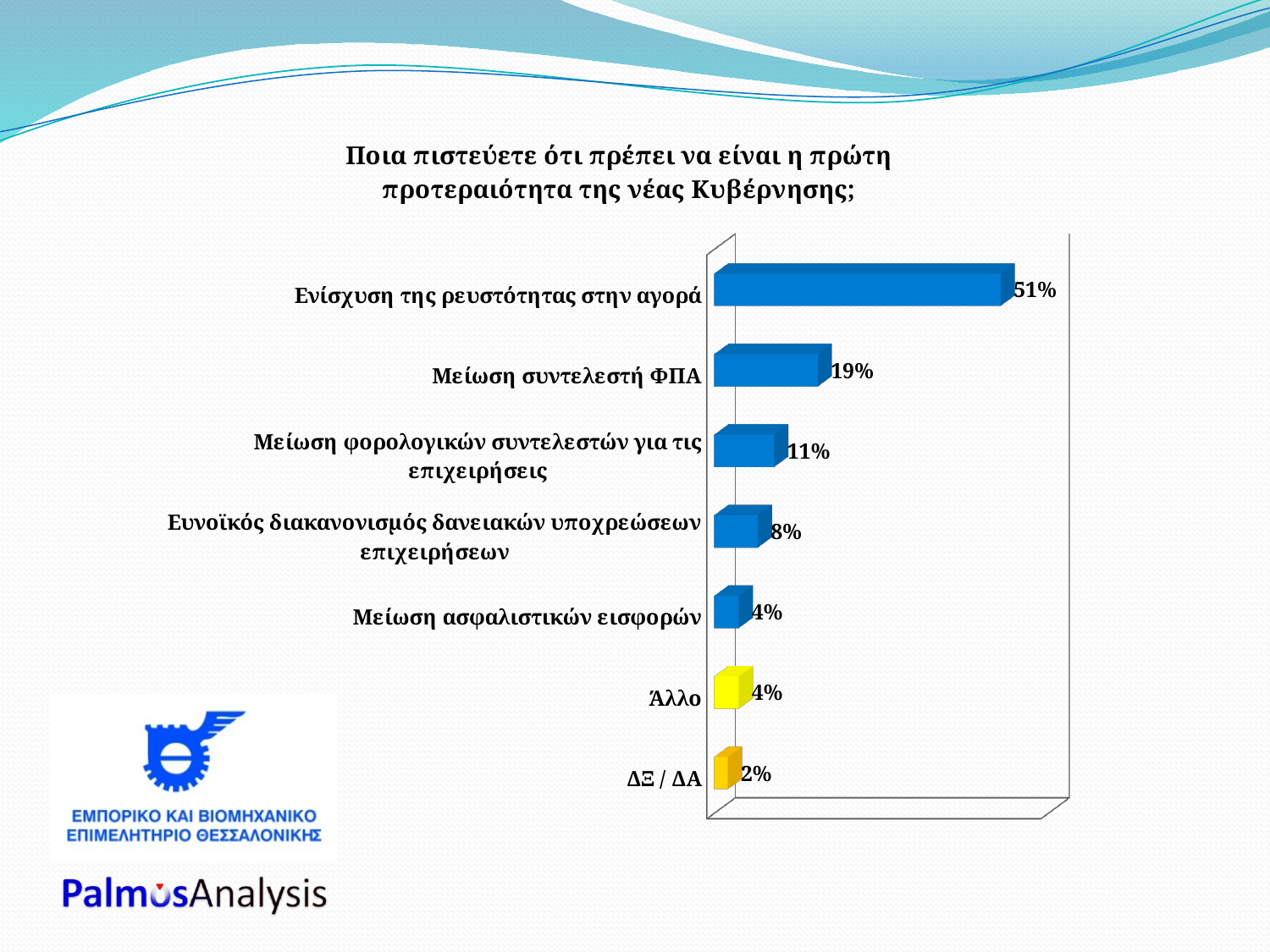
What kind of chart is shown on the slide? Bar chart What percentage is shown for ΔΞ / ΔΑ? 2% Which category has the highest value? Ενίσχυση της ρευστότητας στην αγορά What colour is the bar for Άλλο? Yellow What percentage is shown for Μείωση φορολογικών συντελεστών για τις επιχειρήσεις? 11% How many categories are shown in the chart? 7 What value is shown for Μείωση συντελεστή ΦΠΑ? 19% What value is shown for Ευνοϊκός διακανονισμός δανειακών υποχρεώσεων επιχειρήσεων? 8% What percentage is shown for Ενίσχυση της ρευστότητας στην αγορά? 51% What is the difference between the values for Ενίσχυση της ρευστότητας στην αγορά and Μείωση συντελεστή ΦΠΑ? 32% Which category has the lowest value? ΔΞ / ΔΑ Which is larger: the value for Μείωση συντελεστή ΦΠΑ or the value for Μείωση φορολογικών συντελεστών για τις επιχειρήσεις? Μείωση συντελεστή ΦΠΑ